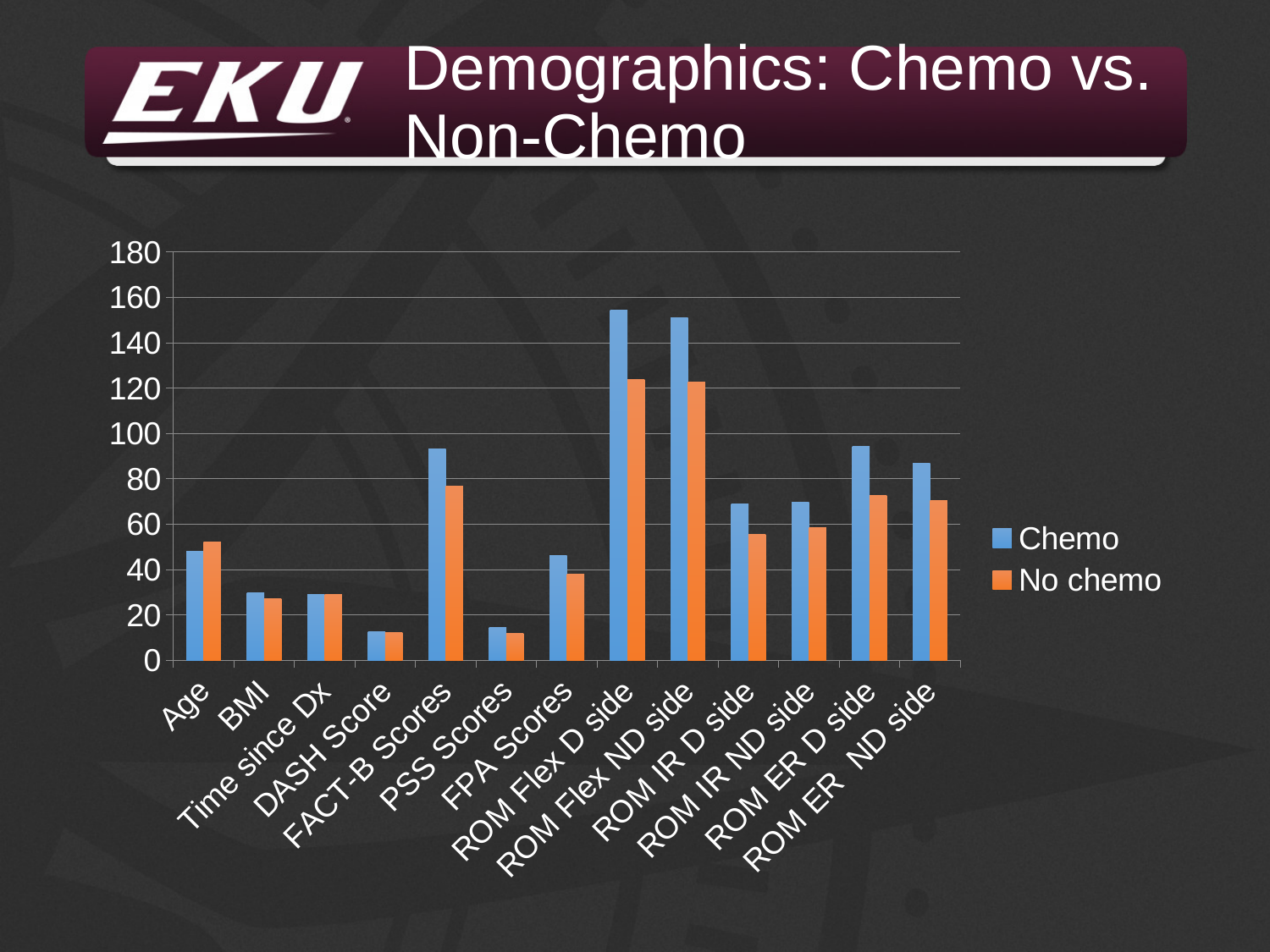
Is the No chemo value for ROM Flex ND side greater or less than 100? greater What is the title of the slide containing the chart? Demographics: Chemo vs. Non-Chemo Is the No chemo value for FPA Scores greater or less than 60? less For Age, which series has the larger value, Chemo or No chemo? No chemo For FACT-B Scores, which series has the larger value, Chemo or No chemo? Chemo Is the Chemo value for Age greater or less than 60? less Which series is shown in orange? No chemo How many series does the legend list? 2 How many categories are shown on the x axis? 13 What type of chart is shown on the slide? Bar chart